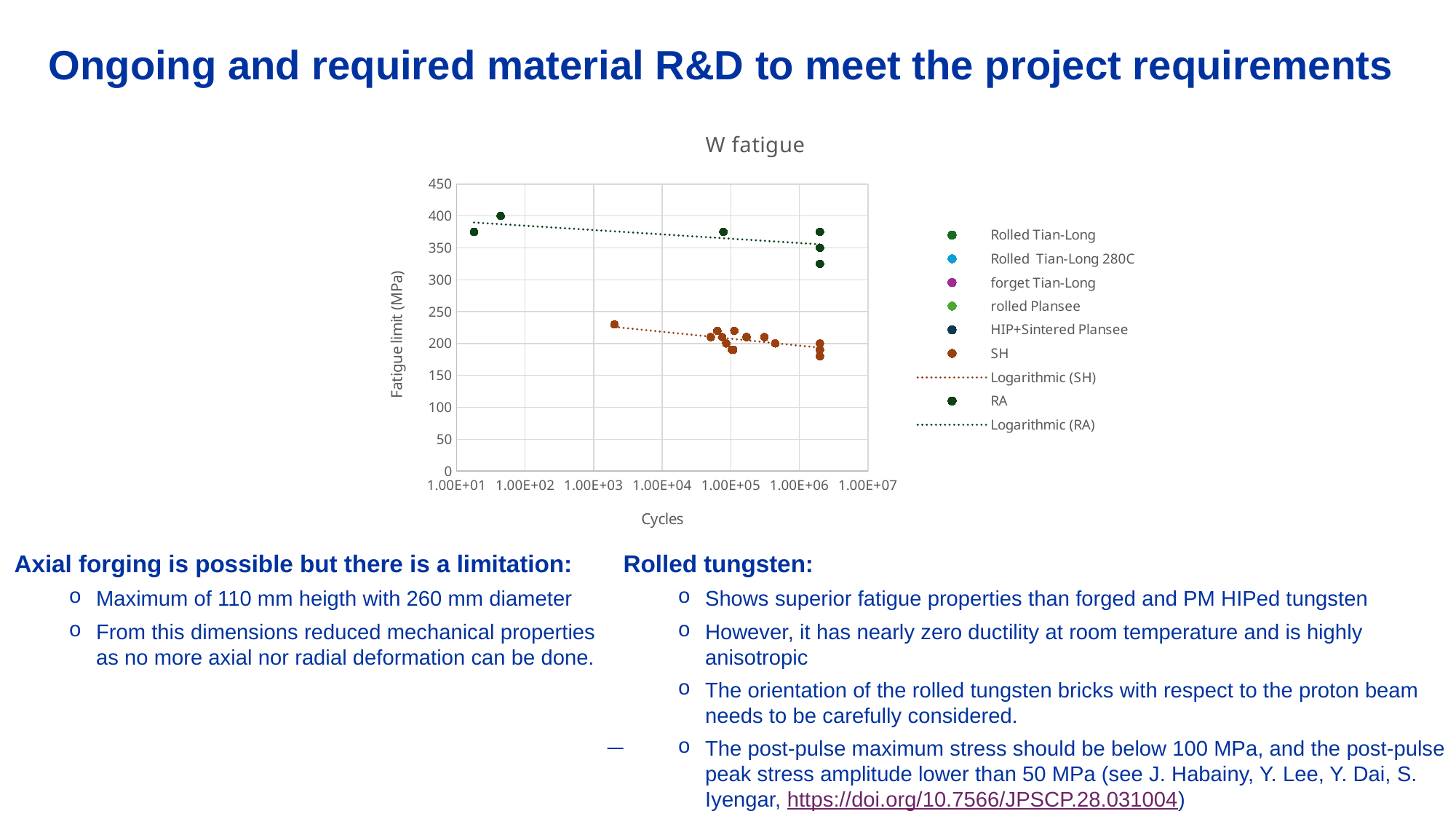
Are the fatigue limit values for the RA series greater or less than 300? greater Is the lowest SH point greater or less than 150? greater How many entries does the chart legend list? 9 What is the title of the chart? W fatigue Does the Logarithmic (SH) trendline rise or fall as the number of cycles increases? fall Which series has higher fatigue limit values, RA or SH? RA Does the Logarithmic (RA) trendline rise or fall as the number of cycles increases? fall Is the highest RA point greater or less than 350? greater What is the label of the vertical axis of the chart? Fatigue limit (MPa) What kind of chart is shown on the slide? scatter chart